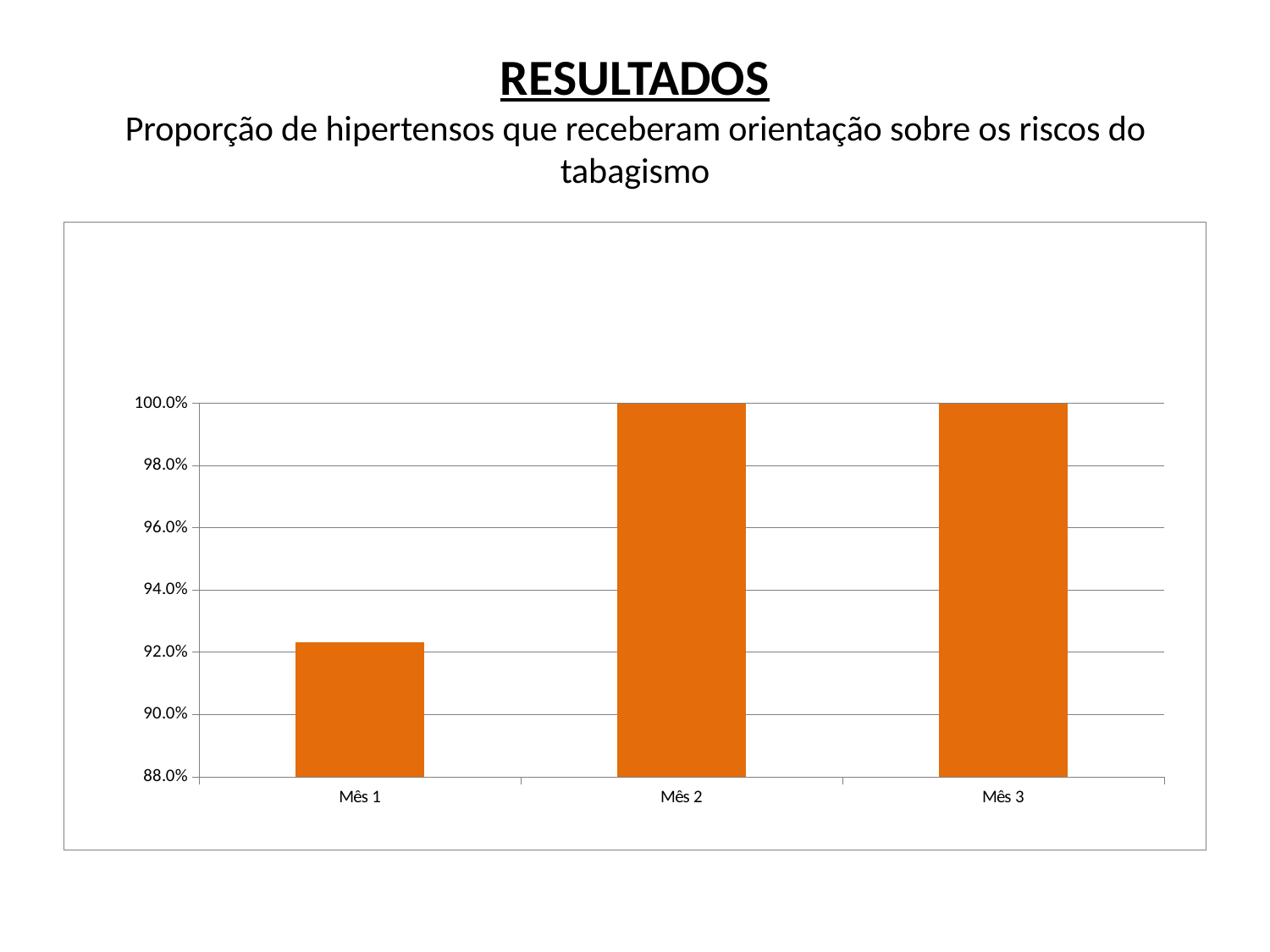
Is the value for Mês 1 greater or less than 90.0%? greater What colour are the bars in the chart? orange What is the value for Mês 2? 100.0% Is the value for Mês 1 greater or less than 94.0%? less What is the value for Mês 3? 100.0% Do the values rise or fall from Mês 1 to Mês 3? rise What kind of chart is shown on the slide? bar chart Which category has the lowest value? Mês 1 What is the lowest value shown on the y axis? 88.0% Which is larger, the value for Mês 1 or the value for Mês 2? Mês 2 How many categories are plotted on the x axis? 3